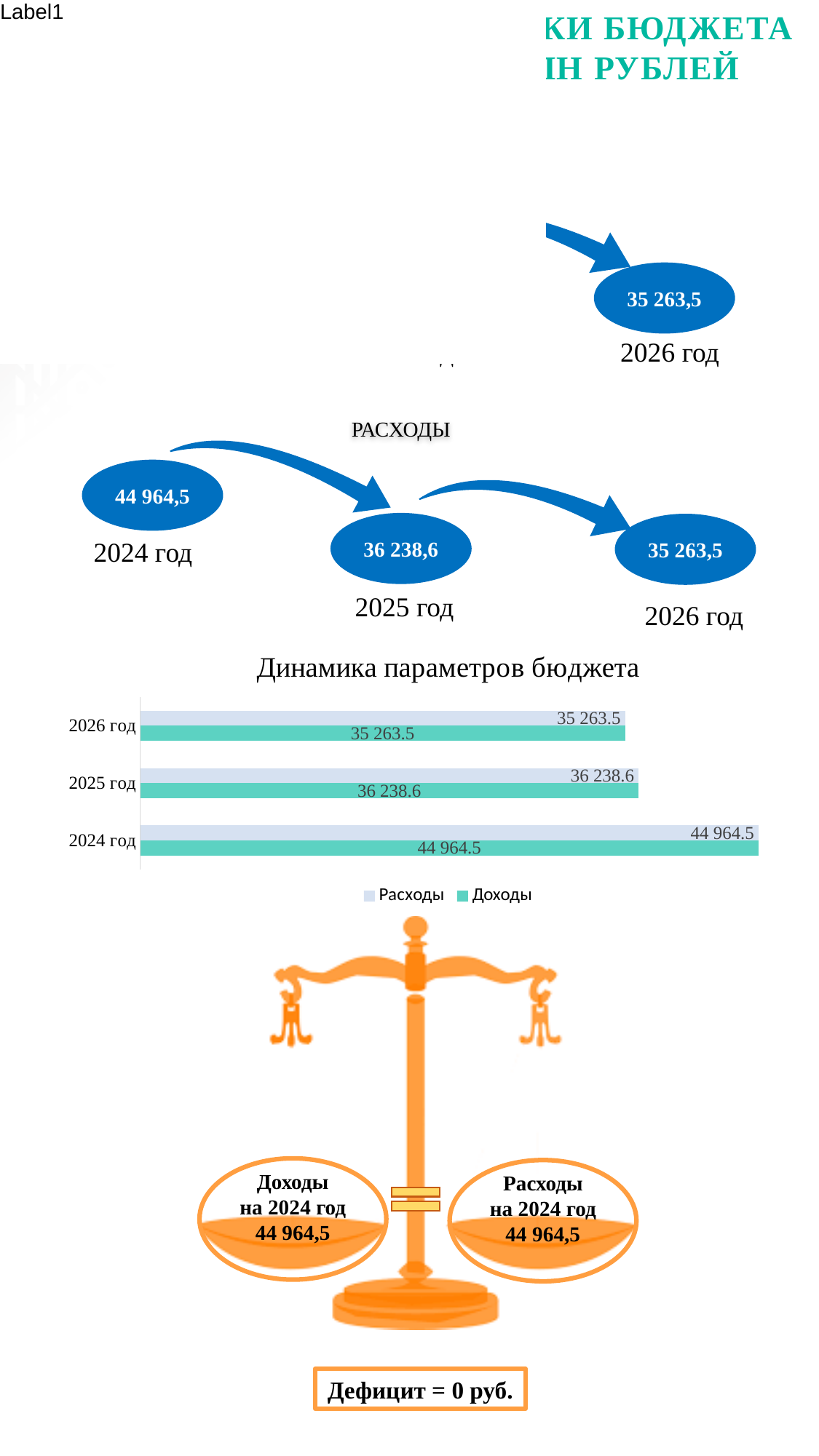
How many series does the legend of the chart "Динамика параметров бюджета" list? 2 In the chart "Динамика параметров бюджета", what is the value of Доходы for 2025 год? 36 238.6 In the chart "Динамика параметров бюджета", which is larger: Расходы for 2024 год or Расходы for 2026 год? Расходы for 2024 год In the chart "Динамика параметров бюджета", which year has the highest value of Доходы? 2024 год In the chart "Динамика параметров бюджета", which year has the lowest value of Расходы? 2026 год What kind of chart is "Динамика параметров бюджета"? bar chart In the chart "Динамика параметров бюджета", what is the difference between Расходы for 2025 год and Расходы for 2026 год? 975.1 How many years (categories) are shown in the chart "Динамика параметров бюджета"? 3 In the chart "Динамика параметров бюджета", do the values of Доходы rise or fall from 2024 год to 2026 год? fall In the chart "Динамика параметров бюджета", what is the value of Расходы for 2026 год? 35 263.5 In the chart "Динамика параметров бюджета", what is the value of Расходы for 2024 год? 44 964.5 In the chart "Динамика параметров бюджета", what is the difference between Доходы for 2024 год and Доходы for 2025 год? 8 725.9